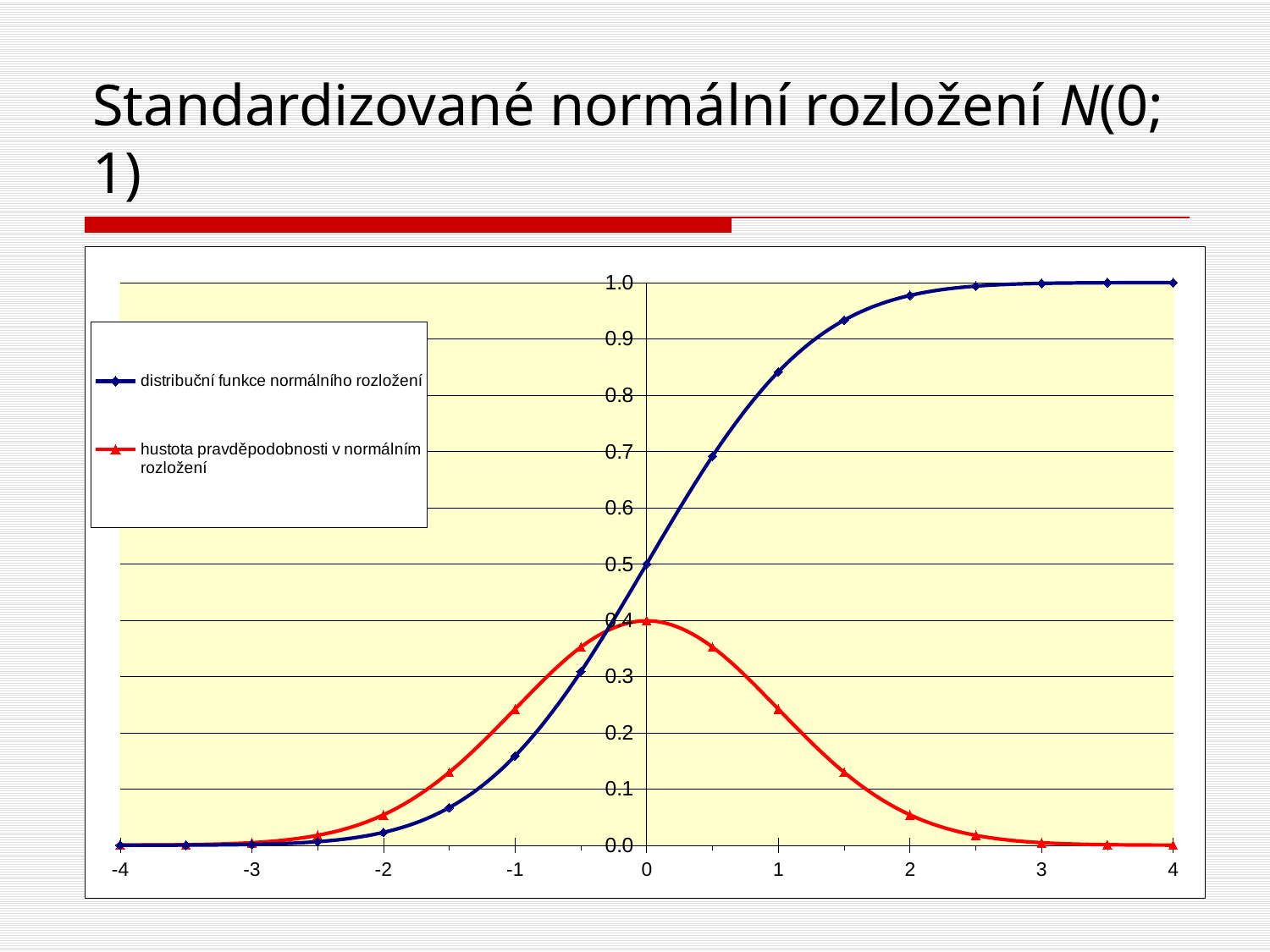
Is the value of the hustota pravděpodobnosti v normálním rozložení series at x = 2 greater or less than 0.1? less Is the value of the distribuční funkce normálního rozložení series at x = 1 greater or less than 0.8? greater Is the value of the distribuční funkce normálního rozložení series at x = -1 greater or less than 0.2? less How many series does the legend list? 2 Which series is drawn in blue with diamond markers? distribuční funkce normálního rozložení At which x value does the hustota pravděpodobnosti v normálním rozložení series reach its maximum? 0 Does the distribuční funkce normálního rozložení series rise or fall as x increases from -4 to 4? rise At x = 1, which series has the higher value? distribuční funkce normálního rozložení What is the value of the distribuční funkce normálního rozložení series at x = 0? 0.5 What kind of chart is shown on the slide? line chart Which series is drawn in red with triangle markers? hustota pravděpodobnosti v normálním rozložení